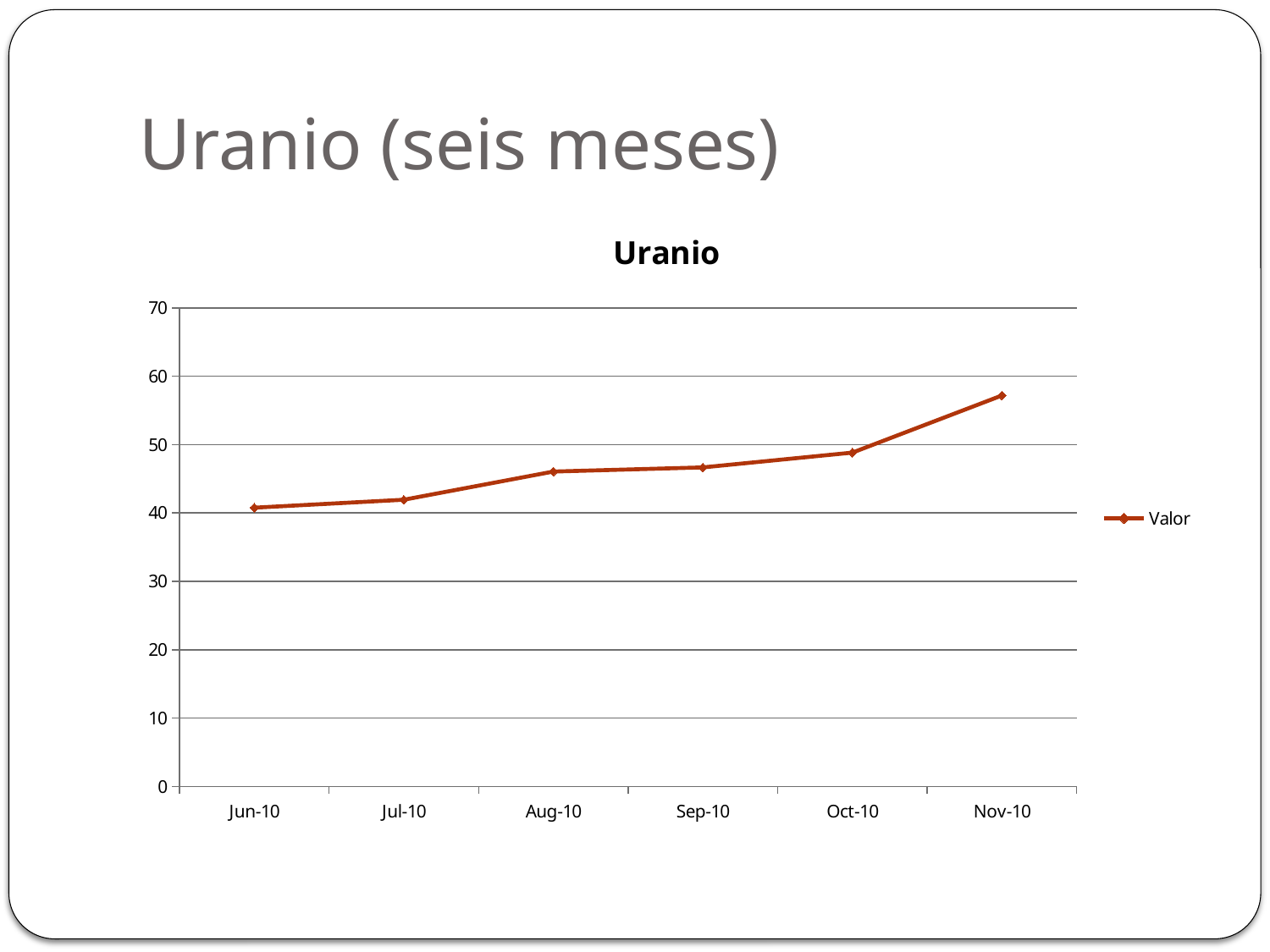
How many data points are plotted on the chart? 6 Which month has the lowest value? Jun-10 How many series does the legend list? 1 What is the name of the series shown in the legend? Valor What is the title of the chart? Uranio Is the value for Nov-10 greater or less than 50? greater Which month has the highest value? Nov-10 What kind of chart is shown on the slide? line chart Is the value for Aug-10 greater or less than 40? greater Do the values rise or fall from Jun-10 to Nov-10? rise Is the value for Jun-10 greater or less than 50? less Which is larger, the value for Oct-10 or the value for Jul-10? Oct-10